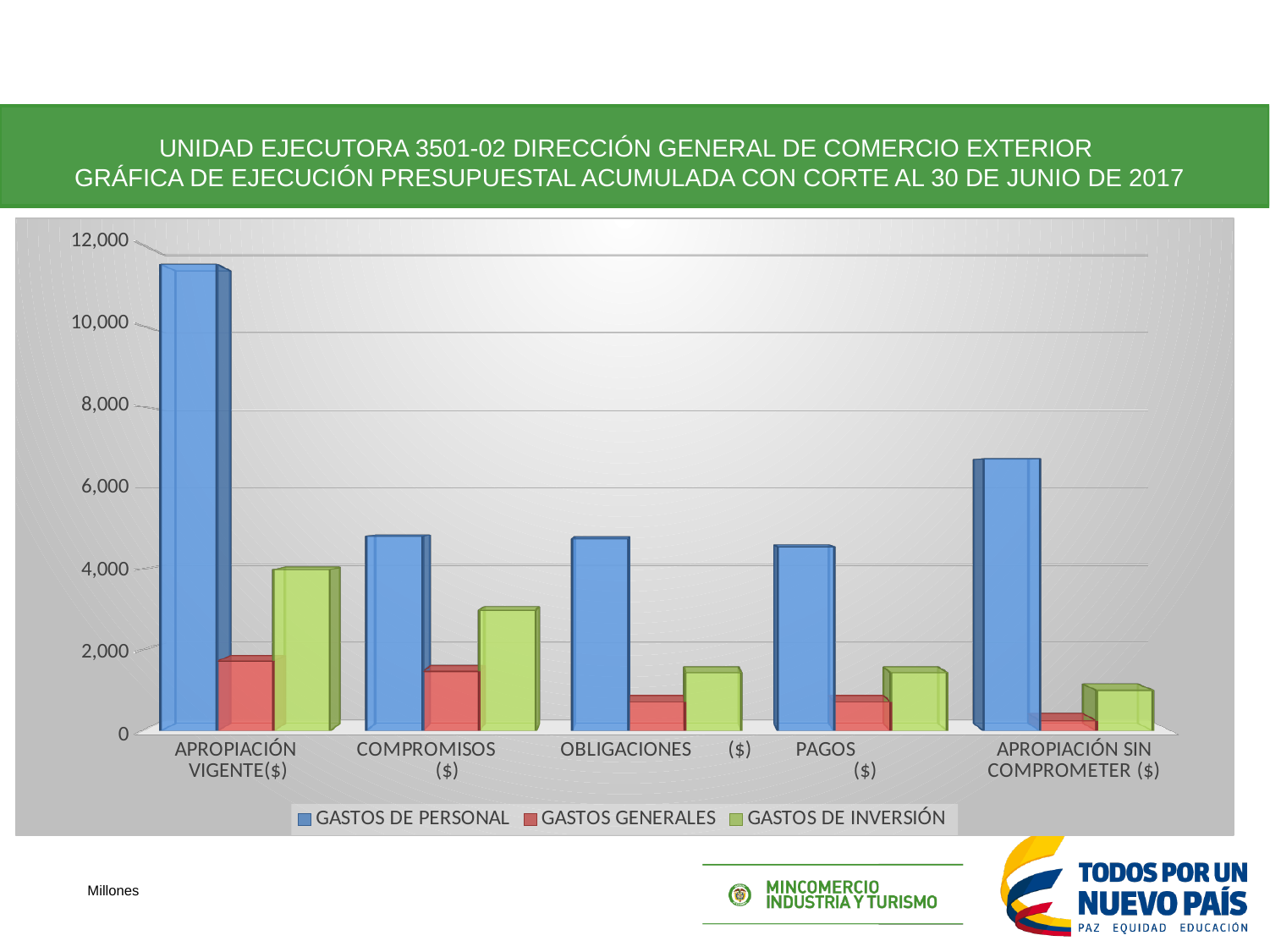
Which category has the lowest GASTOS GENERALES bar? APROPIACIÓN SIN COMPROMETER ($) Is the GASTOS DE PERSONAL value for APROPIACIÓN VIGENTE($) greater or less than 10,000? greater What kind of chart is shown on the slide? Bar chart For APROPIACIÓN VIGENTE($), which is larger: GASTOS DE PERSONAL or GASTOS DE INVERSIÓN? GASTOS DE PERSONAL Which colour represents GASTOS GENERALES in the legend? Red Is the GASTOS DE INVERSIÓN value for COMPROMISOS ($) greater or less than 2,000? greater Which category has the highest GASTOS DE PERSONAL bar? APROPIACIÓN VIGENTE($) How many series does the legend list? 3 For GASTOS DE INVERSIÓN, which is larger: COMPROMISOS ($) or OBLIGACIONES ($)? COMPROMISOS ($) Is the GASTOS GENERALES value for OBLIGACIONES ($) greater or less than 2,000? less How many categories are shown along the x axis? 5